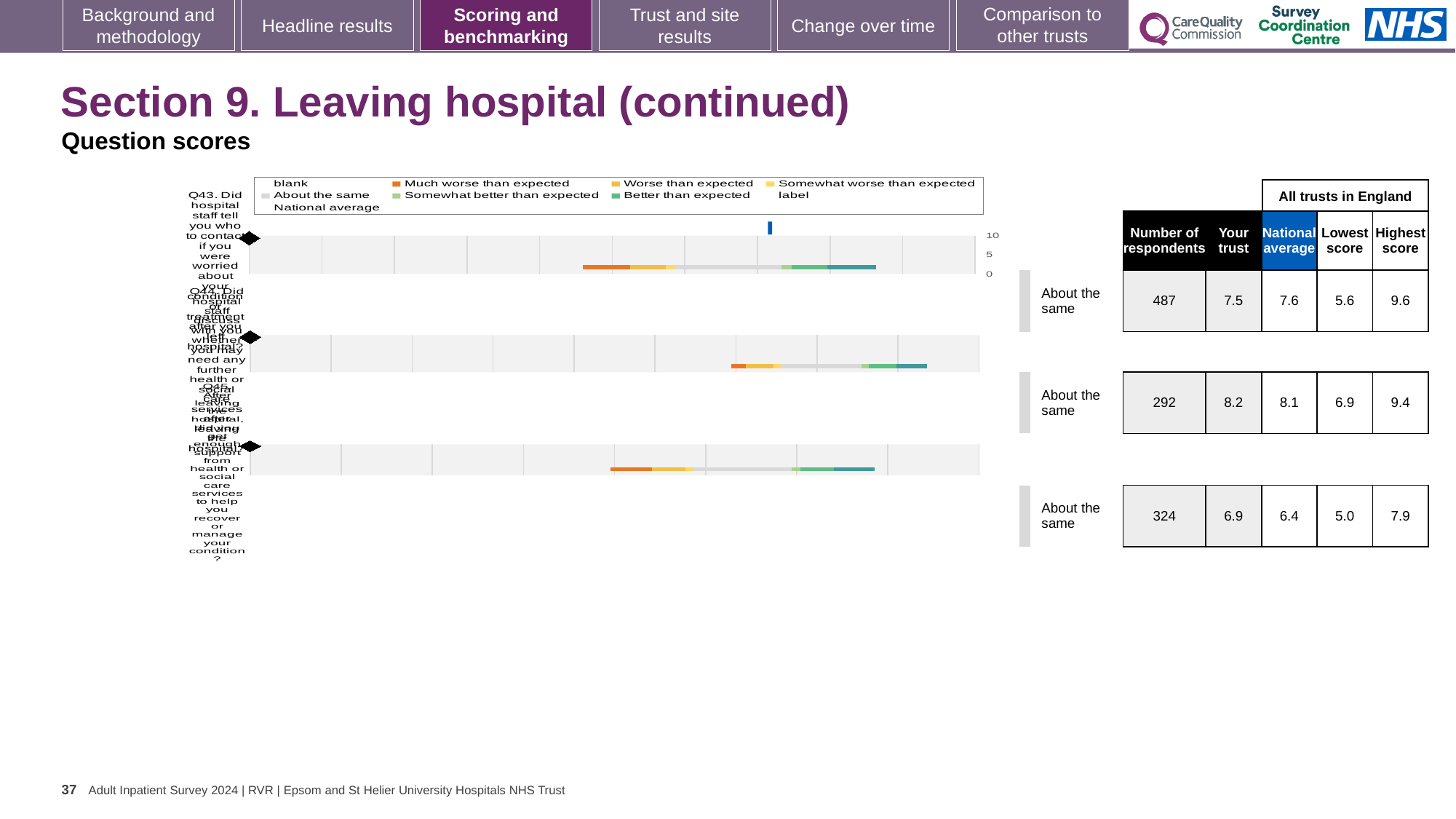
For the second chart row (Q44), which is larger: the 'Your trust' score or the national average? Your trust What kind of chart is used for the question score rows on this slide? bar chart For the third chart row (Q45), what is the lowest score among all trusts in England? 5.0 For the first chart row (Q43), what is the number of respondents? 487 Which chart row has the lowest number of respondents? the second row (Q44), 292 For the third chart row (Q45), what is the difference between the 'Your trust' score and the national average? 0.5 For the third chart row (Q45), what is the highest score among all trusts in England? 7.9 For the second chart row (Q44), what is the national average score? 8.1 For the first chart row (Q43), what is the 'Your trust' score shown in the table? 7.5 How many question score rows (charts) are shown on the slide? 3 What benchmark category label is shown next to each of the three chart rows? About the same Which chart row has the highest 'Your trust' score? the second row (Q44), 8.2